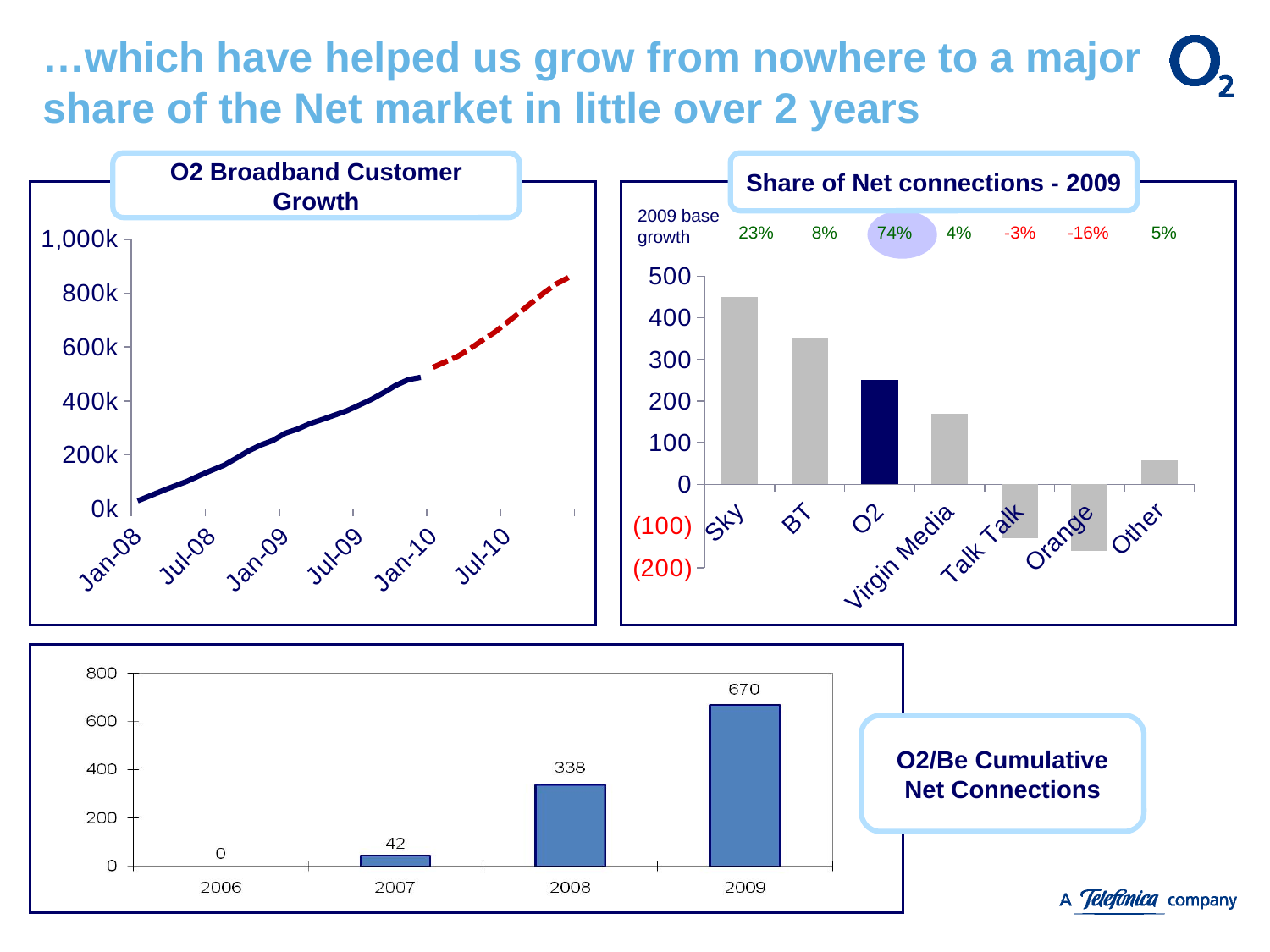
In the O2/Be Cumulative Net Connections chart, which year has the highest value? 2009 In the Share of Net connections - 2009 chart, which provider has the highest bar? Sky In the Share of Net connections - 2009 chart, which provider has the lowest bar? Orange In the O2/Be Cumulative Net Connections chart, what is the value for 2007? 42 What kind of chart is the O2 Broadband Customer Growth chart? line chart In the O2/Be Cumulative Net Connections chart, do the values rise or fall from 2006 to 2009? rise In the O2/Be Cumulative Net Connections chart, what is the difference between the 2009 and 2008 values? 332 In the O2/Be Cumulative Net Connections chart, how many years are shown? 4 In the O2/Be Cumulative Net Connections chart, what is the value for 2009? 670 In the Share of Net connections - 2009 chart, is the value for O2 greater or less than 200? greater In the Share of Net connections - 2009 chart, how many providers are shown on the x axis? 7 In the Share of Net connections - 2009 chart, what 2009 base growth percentage is shown for O2? 74%